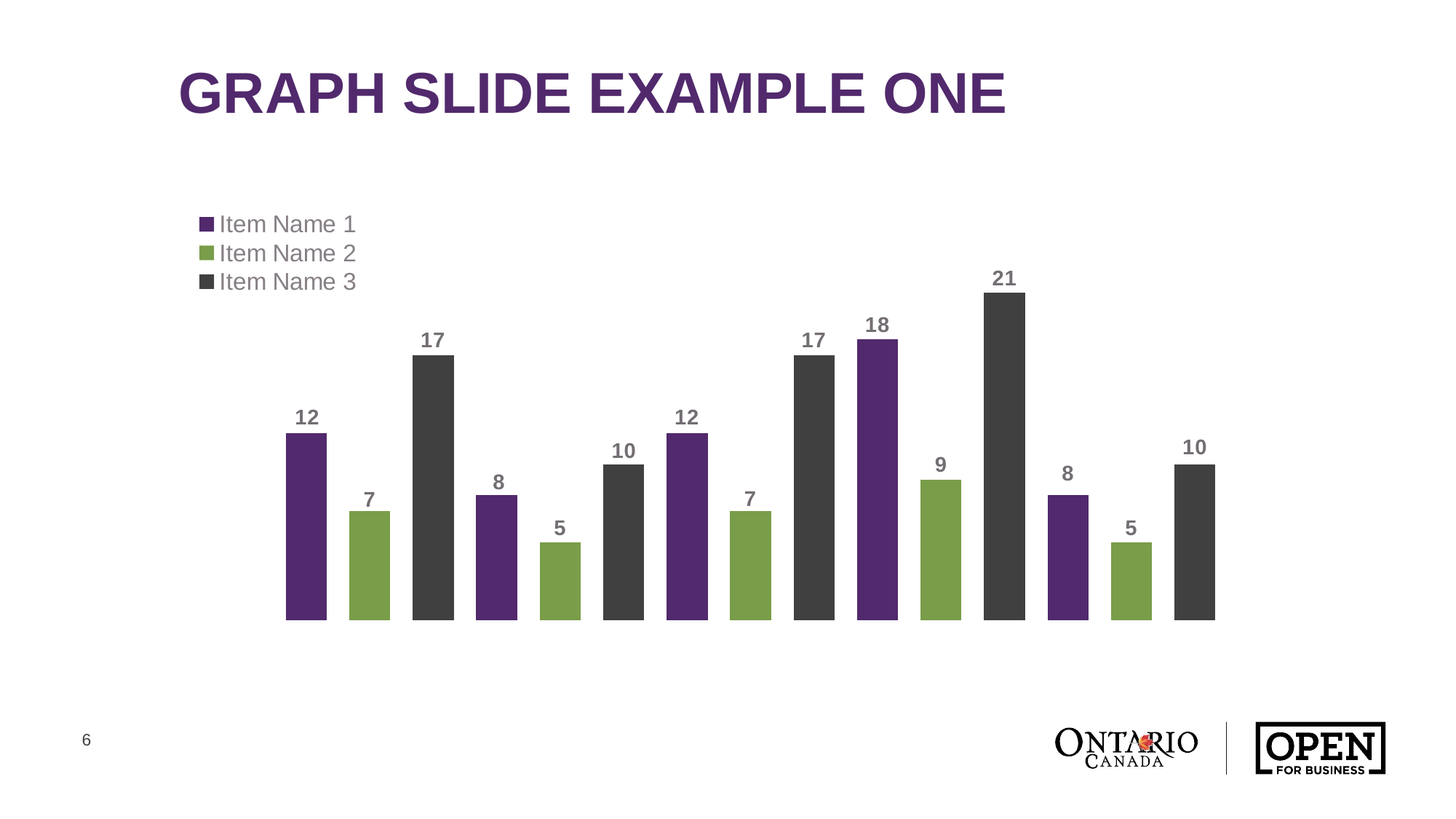
What is the lowest value shown on the chart? 5 What is the highest value shown on the chart? 21 In the first group of bars from the left, which is larger: Item Name 1 or Item Name 3? Item Name 3 What kind of chart is shown on the slide? bar chart What is the value of Item Name 1 in the fourth group of bars from the left? 18 What colour are the Item Name 2 bars? green What is the highest value reached by the Item Name 2 series? 9 What is the title of the slide containing the chart? GRAPH SLIDE EXAMPLE ONE How many series does the legend list? 3 What is the value of Item Name 2 in the first group of bars from the left? 7 How many groups of bars are plotted along the x axis? 5 In the fourth group of bars from the left, what is the difference between Item Name 3 and Item Name 1? 3